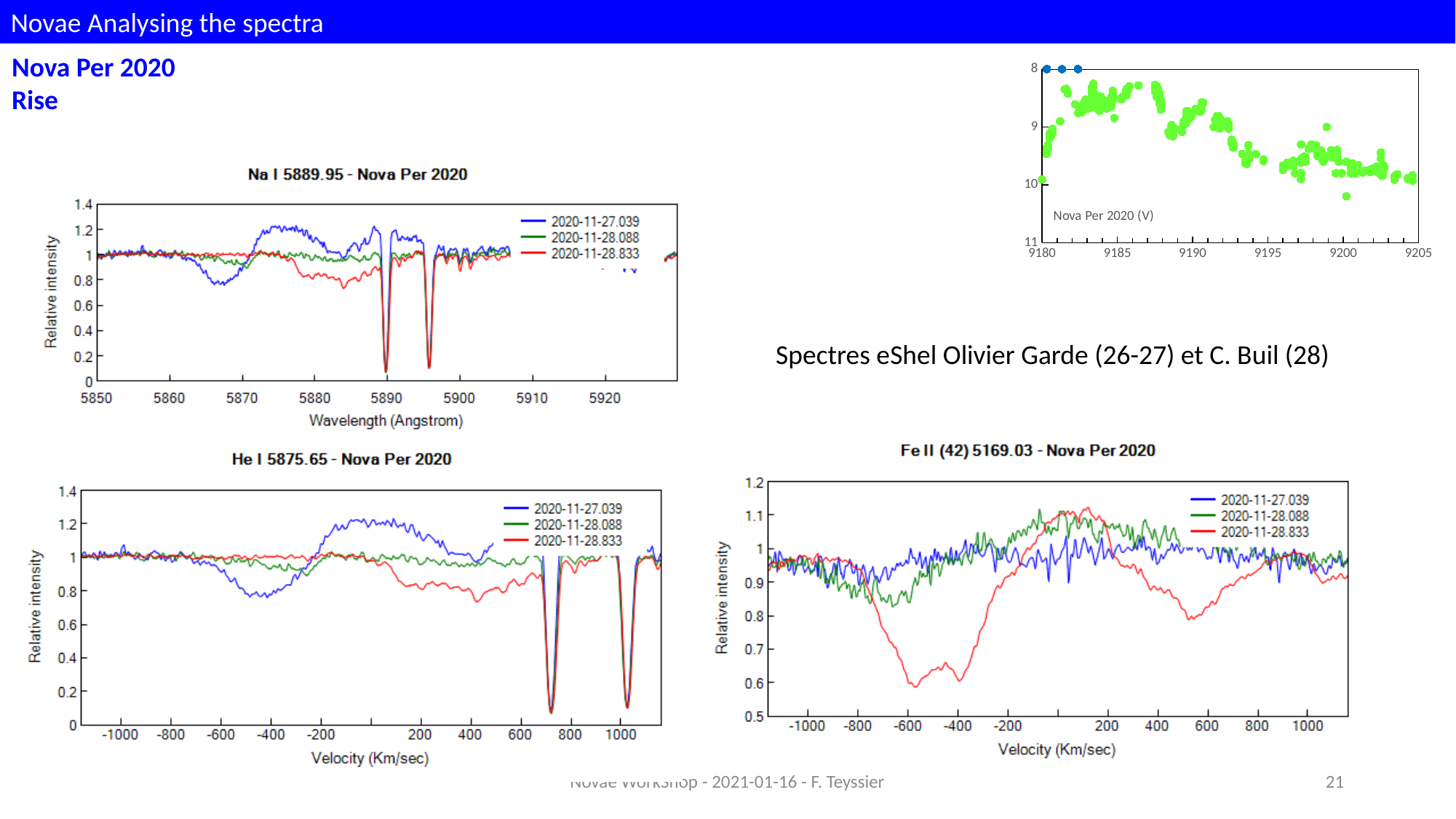
How many series does the legend of the 'Fe II (42) 5169.03 - Nova Per 2020' chart list? 3 In the 'He I 5875.65 - Nova Per 2020' chart, what colour is the 2020-11-28.833 series? red What kind of chart is the 'Na I 5889.95 - Nova Per 2020' chart? line chart What kind of chart is the 'Nova Per 2020 (V)' chart in the top right? scatter chart In the 'He I 5875.65 - Nova Per 2020' chart, is the peak of the blue 2020-11-27.039 series near -100 Km/sec greater or less than 1.0? greater In the 'Na I 5889.95 - Nova Per 2020' chart, is the deepest absorption near 5890 Angstrom greater or less than 0.2? less In the 'Na I 5889.95 - Nova Per 2020' chart, is the blue 2020-11-27.039 series near 5867 Angstrom greater or less than 1.0? less How many series does the legend of the 'He I 5875.65 - Nova Per 2020' chart list? 3 In the 'Fe II (42) 5169.03 - Nova Per 2020' chart, at -600 Km/sec, which series is lower: the red 2020-11-28.833 or the blue 2020-11-27.039? 2020-11-28.833 What is the legend entry shown in the 'Nova Per 2020 (V)' chart in the top right? Nova Per 2020 (V)